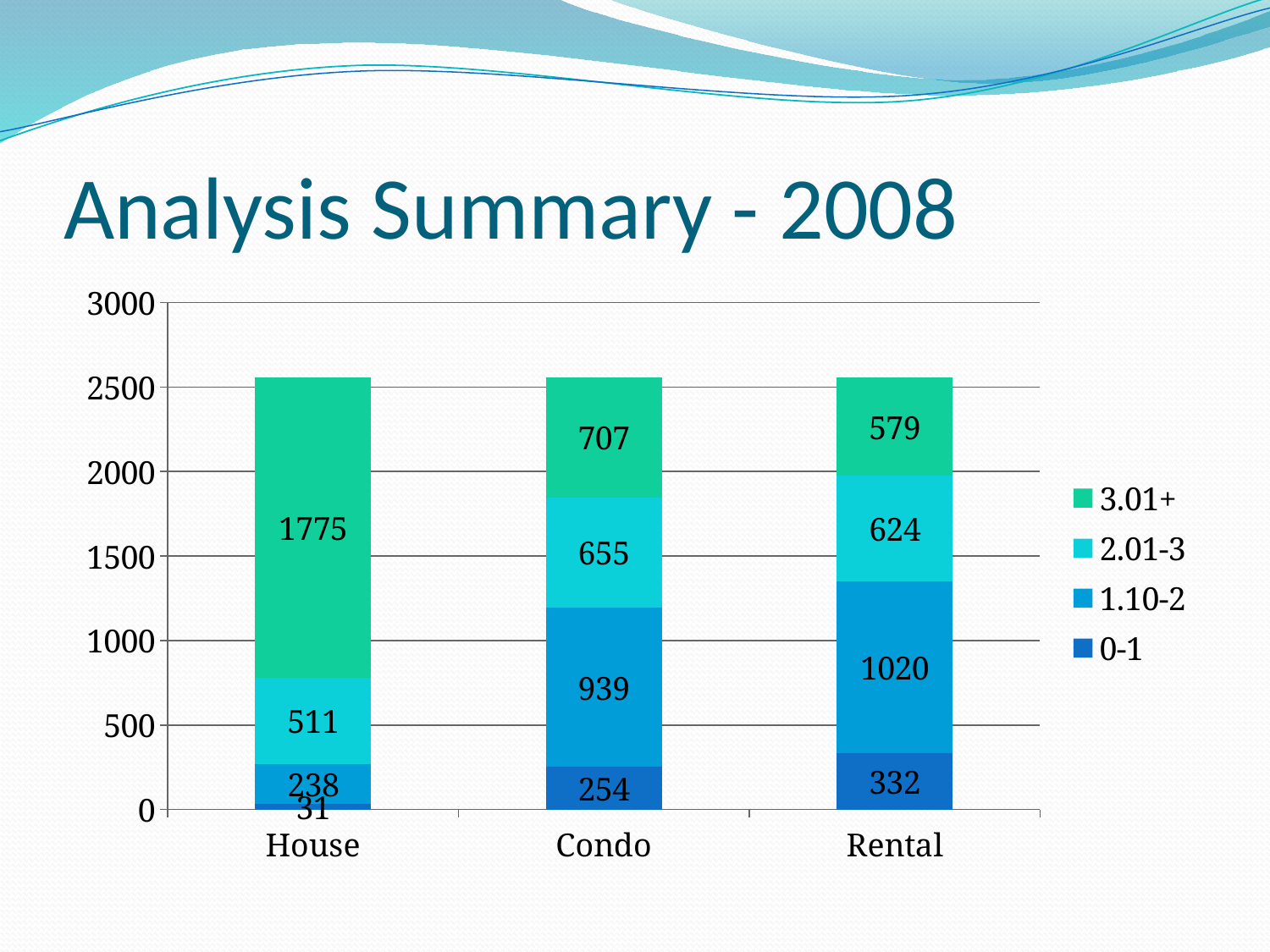
What is the value of the 0-1 segment for Condo? 254 What is the difference between the 1.10-2 values for Rental and Condo? 81 Which category has the highest value for the 3.01+ series? House What is the total of the stacked bar for Condo? 2555 How many categories are shown on the x axis? 3 What is the value of the 3.01+ segment for House? 1775 How many series does the legend list? 4 Which category has the lowest value for the 0-1 series? House What kind of chart is shown on the slide? Stacked bar chart What is the value of the 1.10-2 segment for Rental? 1020 Which is larger, the 3.01+ value for Condo or the 3.01+ value for Rental? Condo What is the value of the 2.01-3 segment for Condo? 655